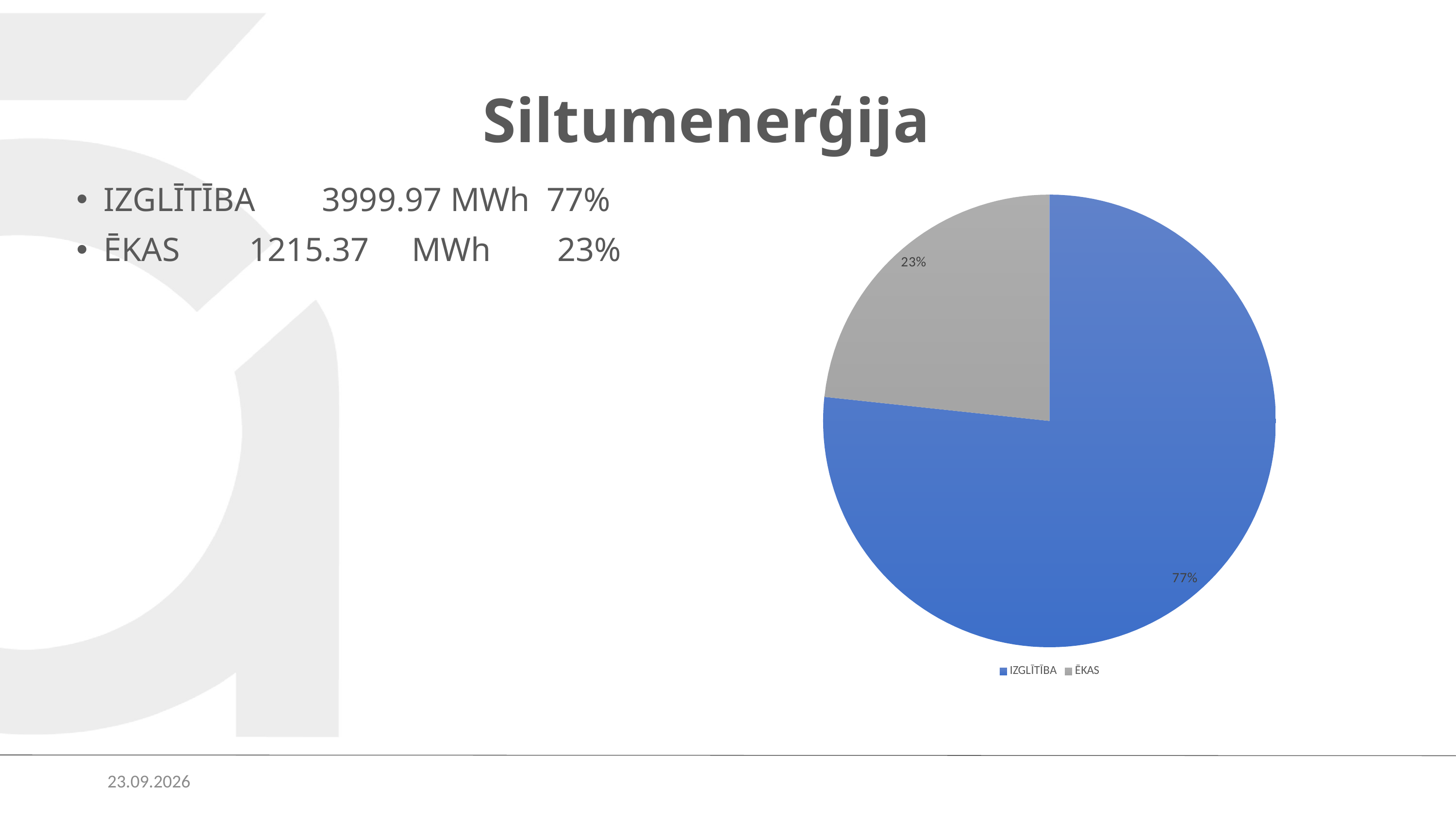
What kind of chart is shown on the slide? pie chart How many slices does the pie chart have? 2 What share of the pie does IZGLĪTĪBA represent? 77% Which is larger in the pie chart, IZGLĪTĪBA or ĒKAS? IZGLĪTĪBA What is the difference in percentage points between the IZGLĪTĪBA and ĒKAS slices? 54 percentage points Which slice of the pie chart is the smallest? ĒKAS What colour is the ĒKAS slice in the pie chart? grey What share of the pie does ĒKAS represent? 23% Which slice of the pie chart is the largest? IZGLĪTĪBA How many entries does the legend of the pie chart list? 2 What colour is the IZGLĪTĪBA slice in the pie chart? blue